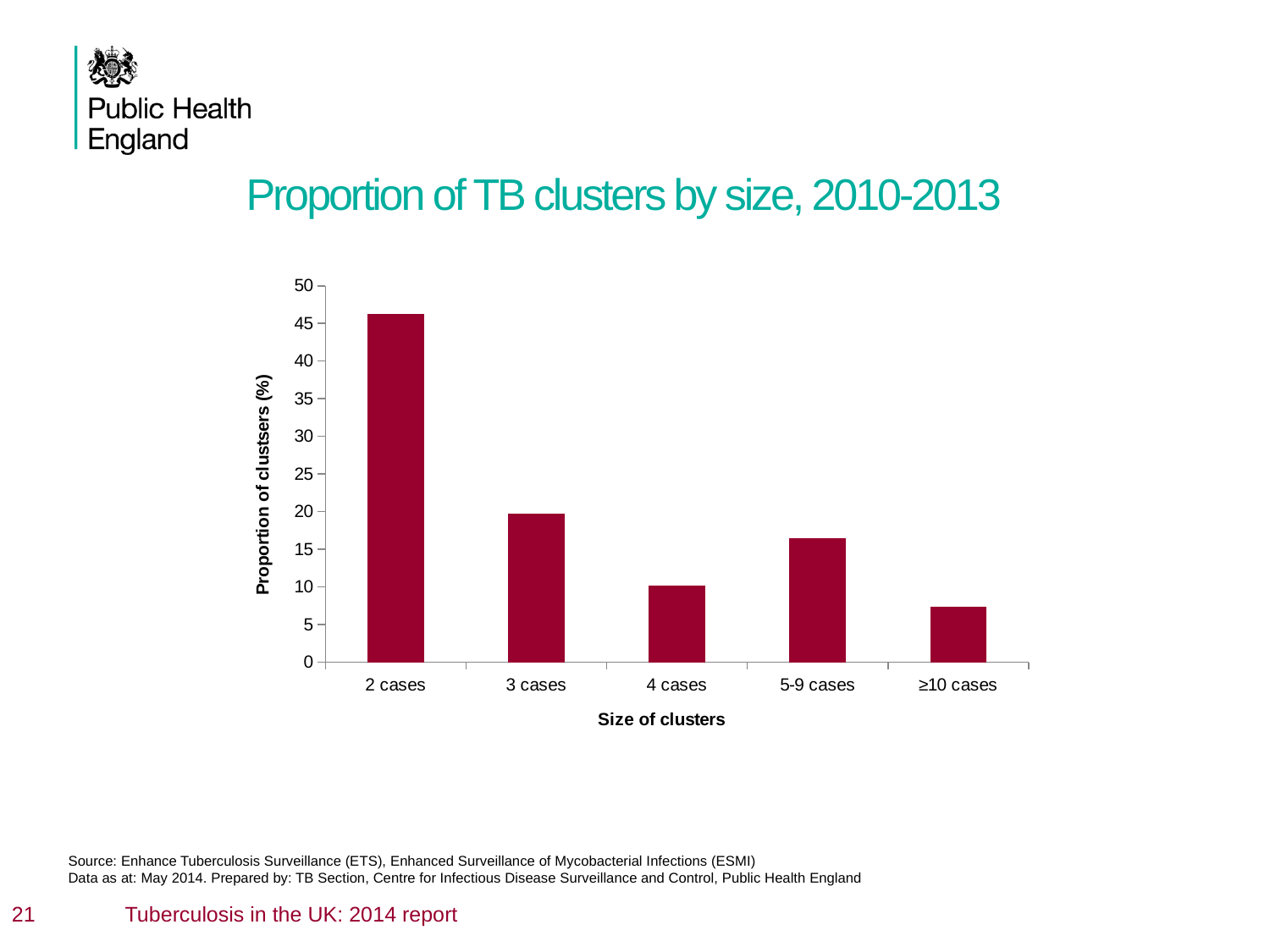
Is the value for 3 cases greater or less than 15? greater Is the value for 4 cases greater or less than 15? less Which cluster size has the lowest proportion of clusters? ≥10 cases Is the value for 2 cases greater or less than 40? greater Which has a larger proportion of clusters, 3 cases or 5-9 cases? 3 cases What kind of chart is shown on the slide? bar chart Do the values rise or fall from 2 cases to 4 cases along the x axis? fall What is the label of the y axis? Proportion of clustsers (%) Which cluster size has the highest proportion of clusters? 2 cases How many cluster size categories are shown on the x axis? 5